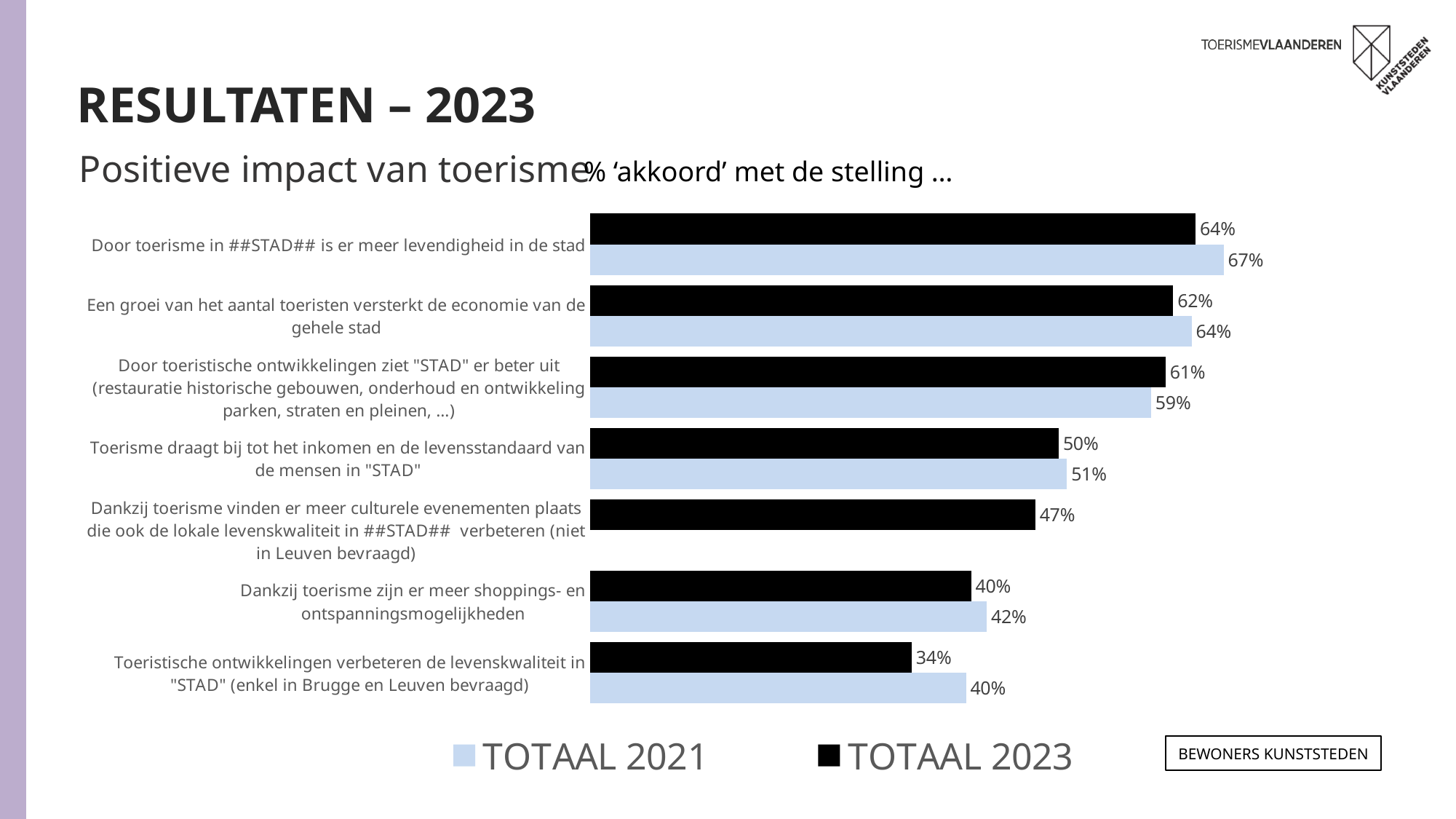
What is the TOTAAL 2023 value for "Door toerisme in ##STAD## is er meer levendigheid in de stad"? 64% How many series does the legend list? 2 What is the difference between the TOTAAL 2021 and TOTAAL 2023 values for "Door toerisme in ##STAD## is er meer levendigheid in de stad"? 3% Which colour represents TOTAAL 2023 in the chart? Black Which statement has the lowest TOTAAL 2023 value? Toeristische ontwikkelingen verbeteren de levenskwaliteit in "STAD" (enkel in Brugge en Leuven bevraagd) What is the TOTAAL 2021 value for "Dankzij toerisme zijn er meer shoppings- en ontspanningsmogelijkheden"? 42% How many statements (categories) are shown in the chart? 7 What is the TOTAAL 2021 value for "Toeristische ontwikkelingen verbeteren de levenskwaliteit in "STAD" (enkel in Brugge en Leuven bevraagd)"? 40% What is the difference between the TOTAAL 2021 and TOTAAL 2023 values for "Toeristische ontwikkelingen verbeteren de levenskwaliteit in "STAD" (enkel in Brugge en Leuven bevraagd)"? 6% What kind of chart is shown on the slide? Bar chart For "Door toeristische ontwikkelingen ziet "STAD" er beter uit", which is larger: the TOTAAL 2021 value or the TOTAAL 2023 value? TOTAAL 2023 Which statement has the highest TOTAAL 2023 value? Door toerisme in ##STAD## is er meer levendigheid in de stad